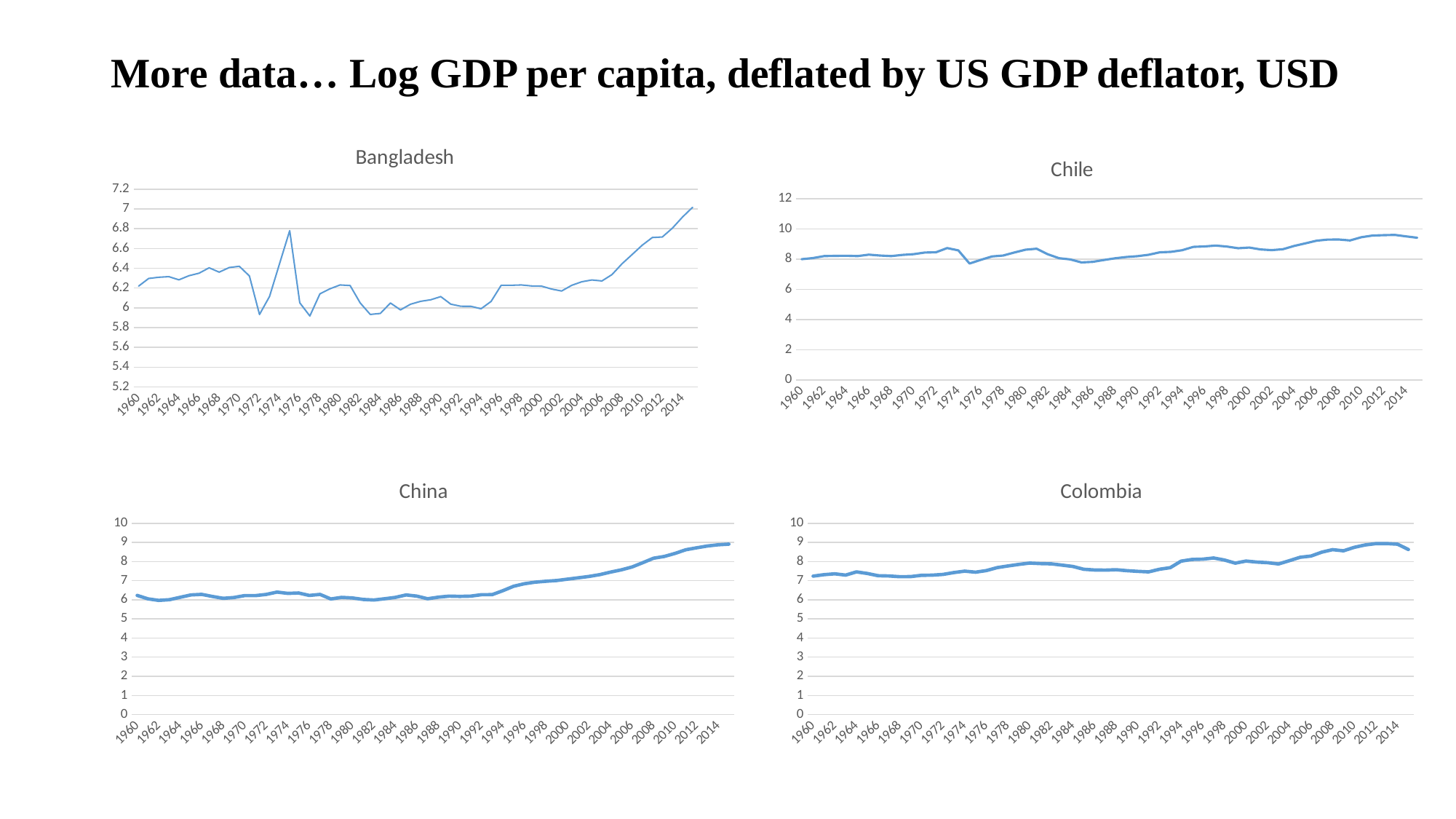
In the Chile chart, is the value for 2014 greater or less than 10? less In the China chart, is the value for 1960 greater or less than 7? less In the Colombia chart, is the value for 1960 greater or less than 6? greater Which chart on the slide has a vertical axis that goes up to 12? Chile What kind of chart is used for the Bangladesh panel? line chart In the China chart, do the values generally rise or fall from 1994 to 2014? rise How many charts are shown on the slide? 4